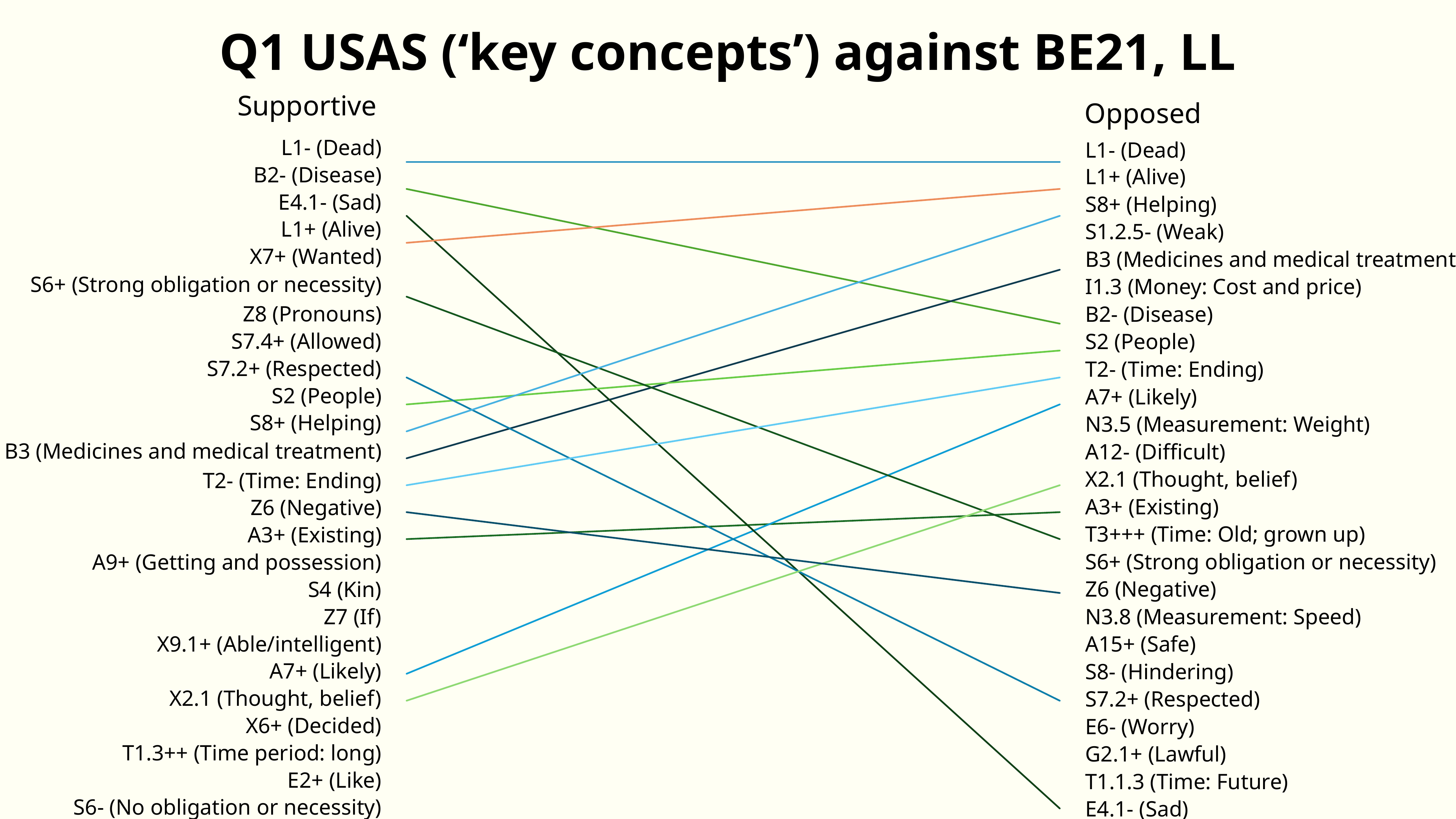
How many key concepts are listed in the Supportive column? 25 What is the title of the chart? Q1 USAS ('key concepts') against BE21, LL Which key concept is ranked first in both the Supportive and Opposed columns? L1- (Dead) Does the line for A7+ (Likely) rise or fall from the Supportive column to the Opposed column? rise What rank does S8+ (Helping) hold in the Opposed column? 3 How many key concepts are listed in the Opposed column? 25 Which key concept is ranked last in the Opposed column? E4.1- (Sad) What kind of chart is shown on the slide? slope chart What are the two column headings of the chart? Supportive and Opposed Which is ranked higher in the Opposed column, L1+ (Alive) or B2- (Disease)? L1+ (Alive) What rank does E4.1- (Sad) hold in the Supportive column? 3 Which key concept is ranked last in the Supportive column? S6- (No obligation or necessity)